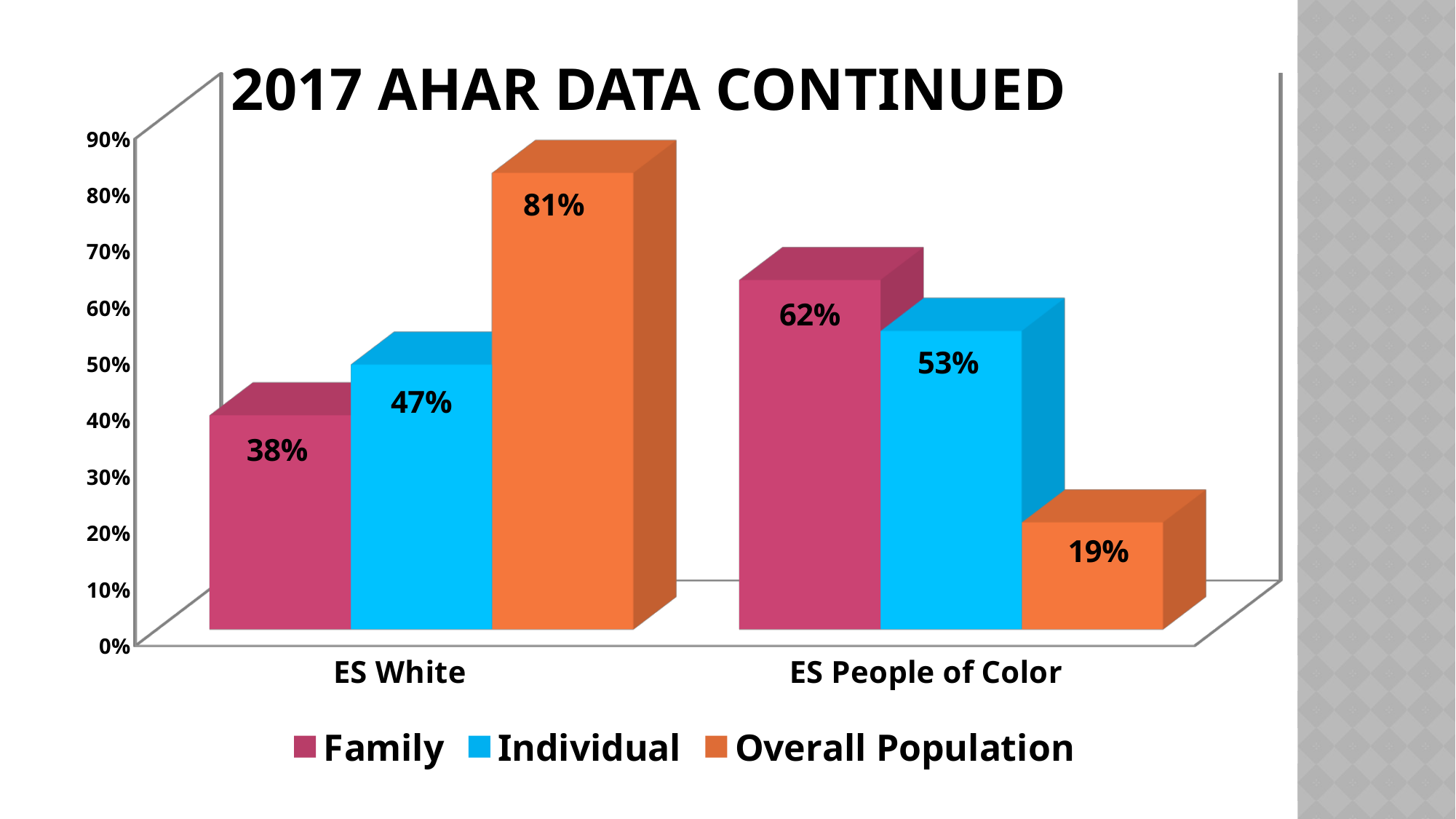
What is the Family value for ES White? 38% Which is larger, the Individual value for ES White or the Individual value for ES People of Color? ES People of Color Which series has the highest value for ES White? Overall Population What is the difference between the Overall Population values for ES White and ES People of Color? 62% What is the Overall Population value for ES People of Color? 19% What is the difference between the Family values for ES People of Color and ES White? 24% How many categories are shown on the x axis? 2 What is the title of the chart? 2017 AHAR DATA CONTINUED What is the Individual value for ES People of Color? 53% What kind of chart is shown on the slide? Bar chart How many series does the legend list? 3 Which series has the lowest value for ES People of Color? Overall Population